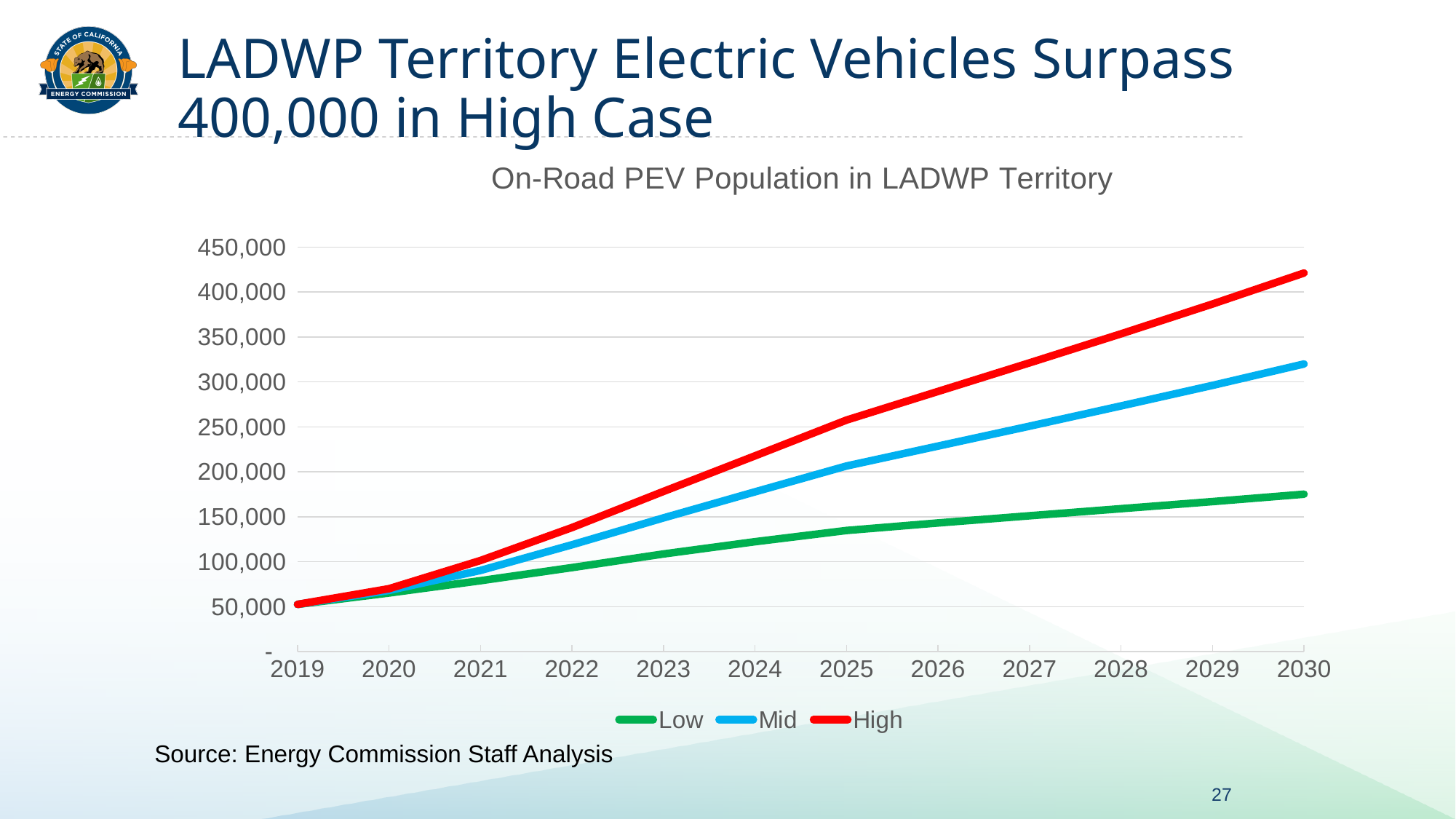
Is the value for the High series in 2030 greater or less than 400,000? greater Which series has the lowest value in 2030? Low How many years are shown along the x axis? 12 What is the title of the chart? On-Road PEV Population in LADWP Territory Is the value for the High series in 2023 greater or less than 150,000? greater Which is larger in 2030, the Mid series or the Low series? Mid What kind of chart is shown on the slide? line chart Which series has the highest value in 2030? High How many series does the legend list? 3 Is the value for the Low series in 2025 greater or less than 150,000? less Do the values of the High series rise or fall from 2019 to 2030? rise